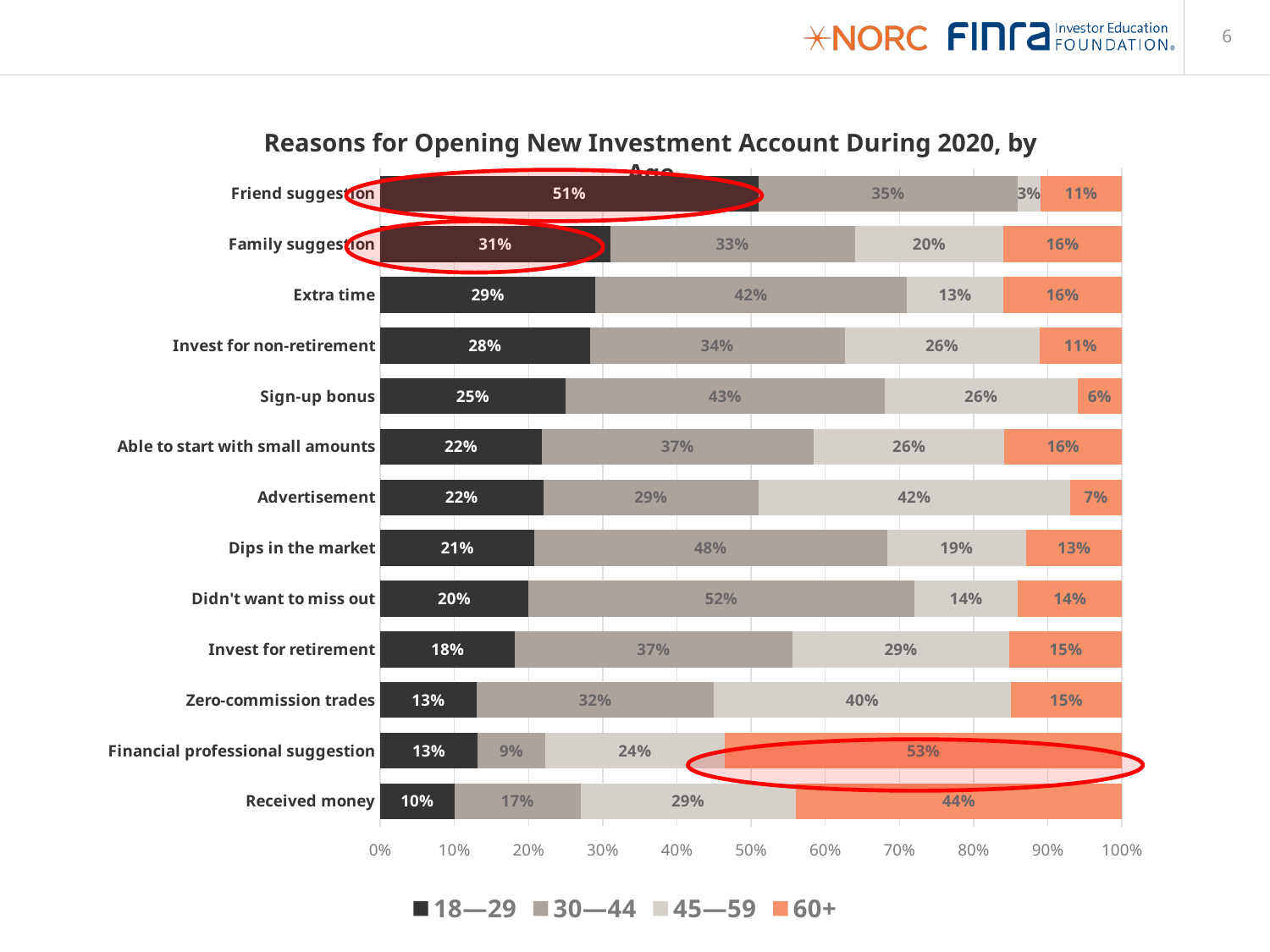
What is the value for the 60+ age group for "Financial professional suggestion"? 53% What kind of chart is shown on the slide? Stacked bar chart For "Advertisement", which age group has the larger value: 30—44 or 45—59? 45—59 What is the difference between the 60+ values for "Financial professional suggestion" and "Received money"? 9% Which age group is represented by the orange segments in the chart? 60+ How many age groups does the legend list? 4 What is the total of the four segments in the "Friend suggestion" bar? 100% Which reason has the highest value for the 18—29 age group? Friend suggestion What percentage of the 18—29 age group cited "Friend suggestion" as a reason for opening a new investment account? 51% Which reason has the lowest value for the 18—29 age group? Received money How many reasons (categories) are shown on the chart? 13 What is the value for the 30—44 age group for "Didn't want to miss out"? 52%